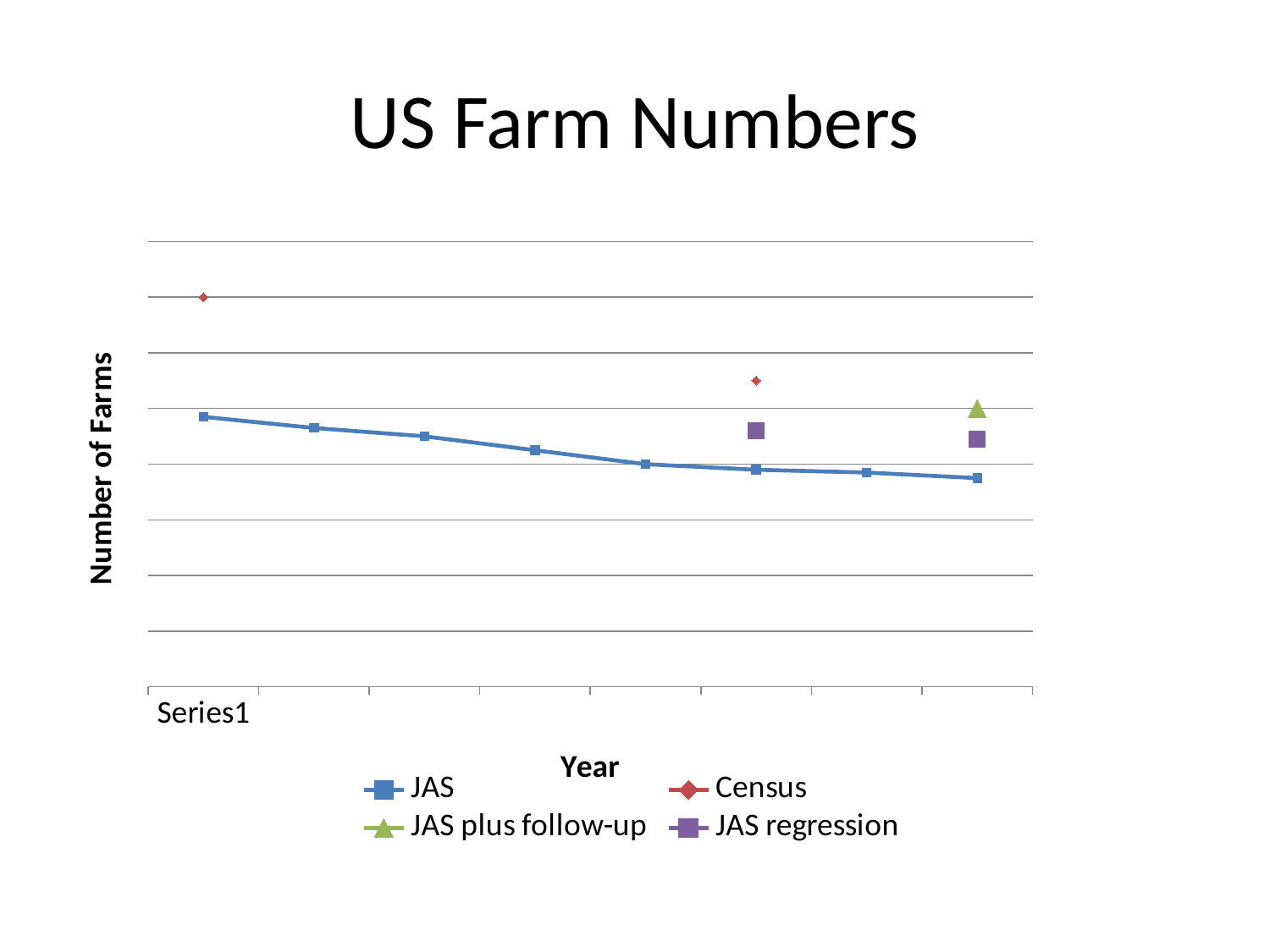
Do the JAS values rise or fall along the x axis? Fall What is the label on the vertical axis? Number of Farms How many data points are plotted for the JAS series? 8 How many series does the legend list? 4 Which series contains the highest plotted point on the chart? Census What kind of chart is shown on the slide? Line chart What is the title of the chart? US Farm Numbers At the last x position, which is higher: JAS plus follow-up or JAS regression? JAS plus follow-up How many data points are plotted for the JAS plus follow-up series? 1 At the first x position, which is higher: the Census value or the JAS value? Census At the sixth x position, which is higher: JAS regression or JAS? JAS regression How many data points are plotted for the Census series? 2